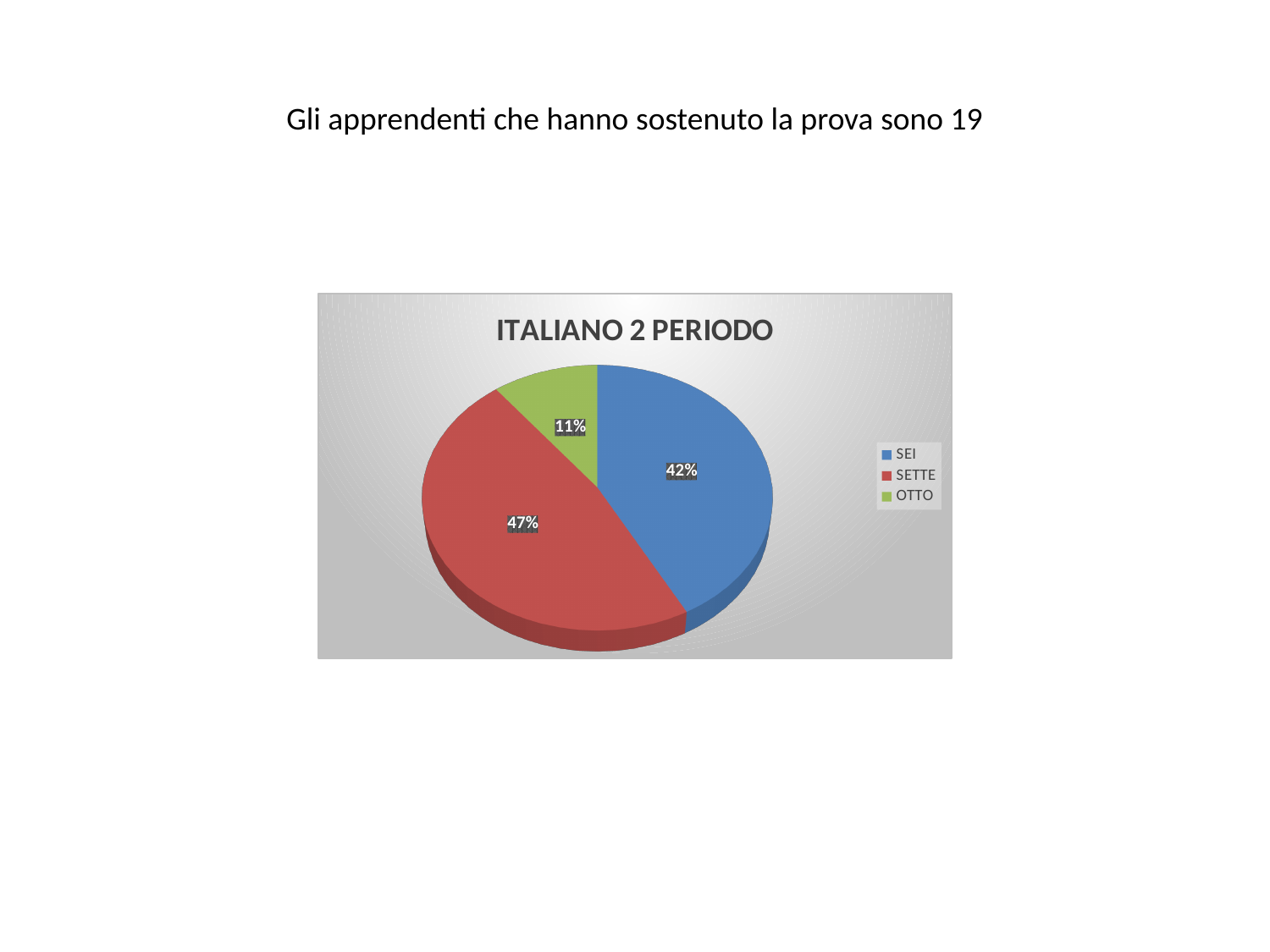
Which category has the largest slice of the pie? SETTE What is the title of the chart? ITALIANO 2 PERIODO Which slice is larger, SEI or OTTO? SEI Which category has the smallest slice of the pie? OTTO How many categories are shown in the pie chart? 3 What share of the pie does OTTO represent? 11% What kind of chart is shown on the slide? Pie chart What share of the pie does SEI represent? 42% Which colour represents SETTE in the legend? Red What is the difference in percentage points between the SEI and OTTO slices? 31% What share of the pie does SETTE represent? 47% What is the difference in percentage points between the SETTE and SEI slices? 5%